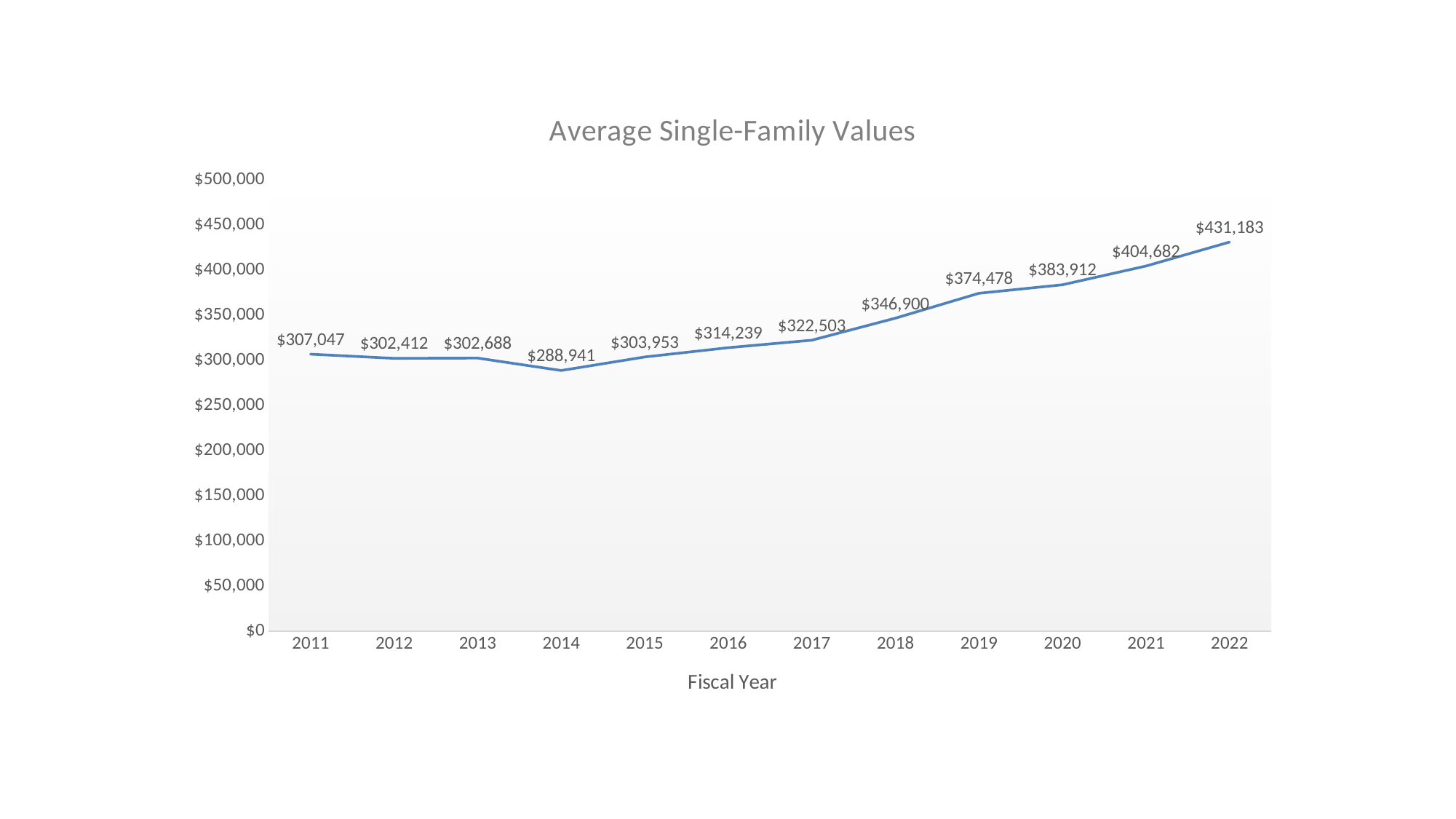
What is the difference between the average single-family values for 2011 and 2014? $18,106 What is the difference between the average single-family values for 2022 and 2021? $26,501 What is the average single-family value for fiscal year 2014? $288,941 How many fiscal years are plotted on the chart? 12 What is the title of the chart? Average Single-Family Values What is the average single-family value for fiscal year 2018? $346,900 Which fiscal year has the highest average single-family value? 2022 Which fiscal year has a larger average single-family value, 2019 or 2017? 2019 Which fiscal year has the lowest average single-family value? 2014 Is the average single-family value for 2020 greater or less than $350,000? greater What kind of chart is shown on the slide? Line chart What is the average single-family value for fiscal year 2022? $431,183